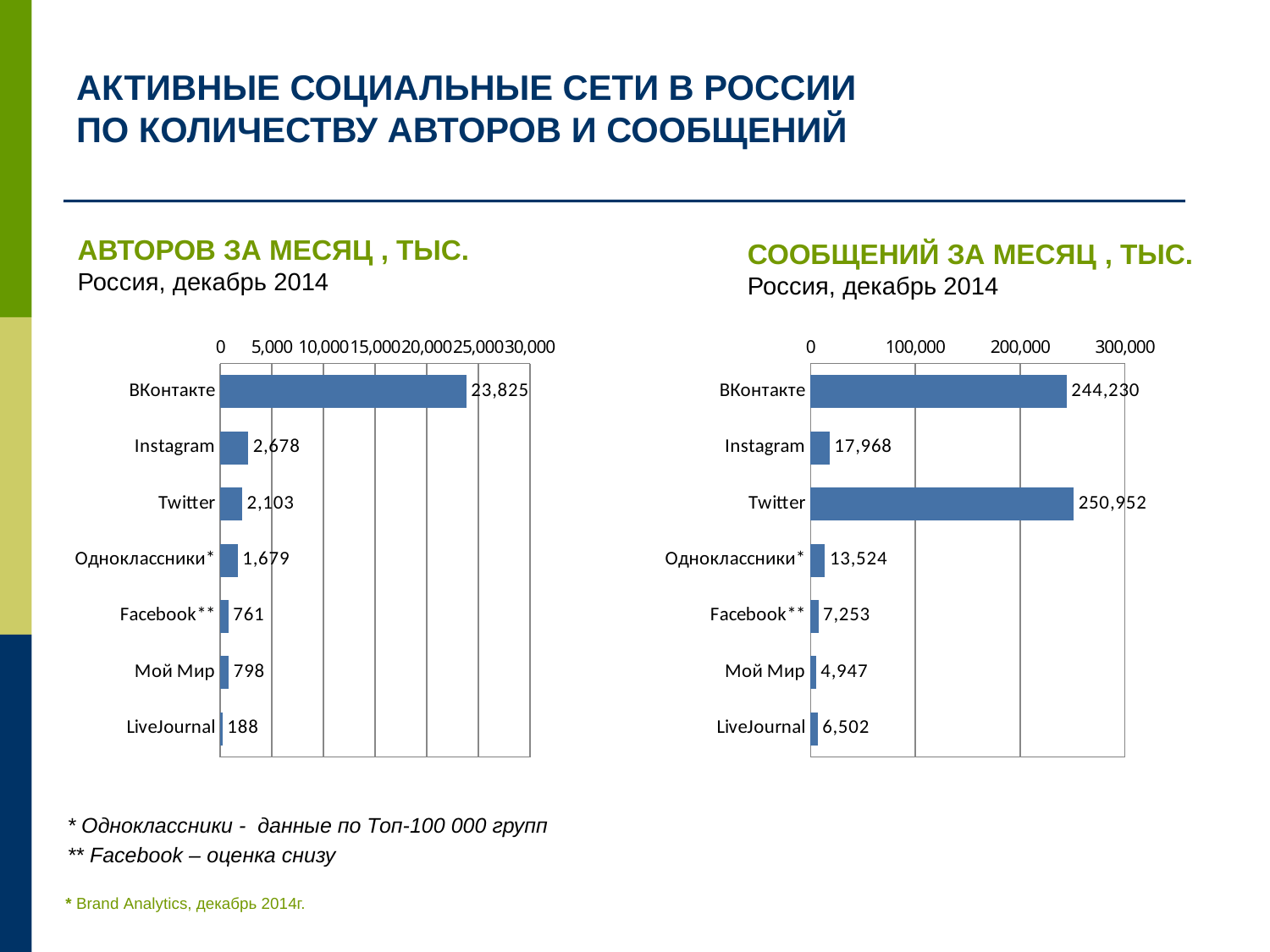
In the 'СООБЩЕНИЙ ЗА МЕСЯЦ, ТЫС.' chart on the right, what is the value for Twitter? 250,952 In the 'АВТОРОВ ЗА МЕСЯЦ, ТЫС.' chart on the left, what is the difference between Instagram and Twitter? 575 In the 'СООБЩЕНИЙ ЗА МЕСЯЦ, ТЫС.' chart on the right, what is the difference between Twitter and ВКонтакте? 6,722 In the 'СООБЩЕНИЙ ЗА МЕСЯЦ, ТЫС.' chart on the right, which category has the highest value? Twitter In the 'АВТОРОВ ЗА МЕСЯЦ, ТЫС.' chart on the left, what is the value for ВКонтакте? 23,825 In the 'СООБЩЕНИЙ ЗА МЕСЯЦ, ТЫС.' chart on the right, what is the value for Мой Мир? 4,947 In the 'АВТОРОВ ЗА МЕСЯЦ, ТЫС.' chart on the left, which is larger: Facebook** or Мой Мир? Мой Мир What kind of chart is the 'СООБЩЕНИЙ ЗА МЕСЯЦ, ТЫС.' chart on the right? Bar chart In the 'СООБЩЕНИЙ ЗА МЕСЯЦ, ТЫС.' chart on the right, is the value for Instagram greater or less than 100,000? less How many categories are shown in the 'АВТОРОВ ЗА МЕСЯЦ, ТЫС.' chart on the left? 7 In the 'АВТОРОВ ЗА МЕСЯЦ, ТЫС.' chart on the left, which category has the lowest value? LiveJournal In the 'СООБЩЕНИЙ ЗА МЕСЯЦ, ТЫС.' chart on the right, which category has the lowest value? Мой Мир